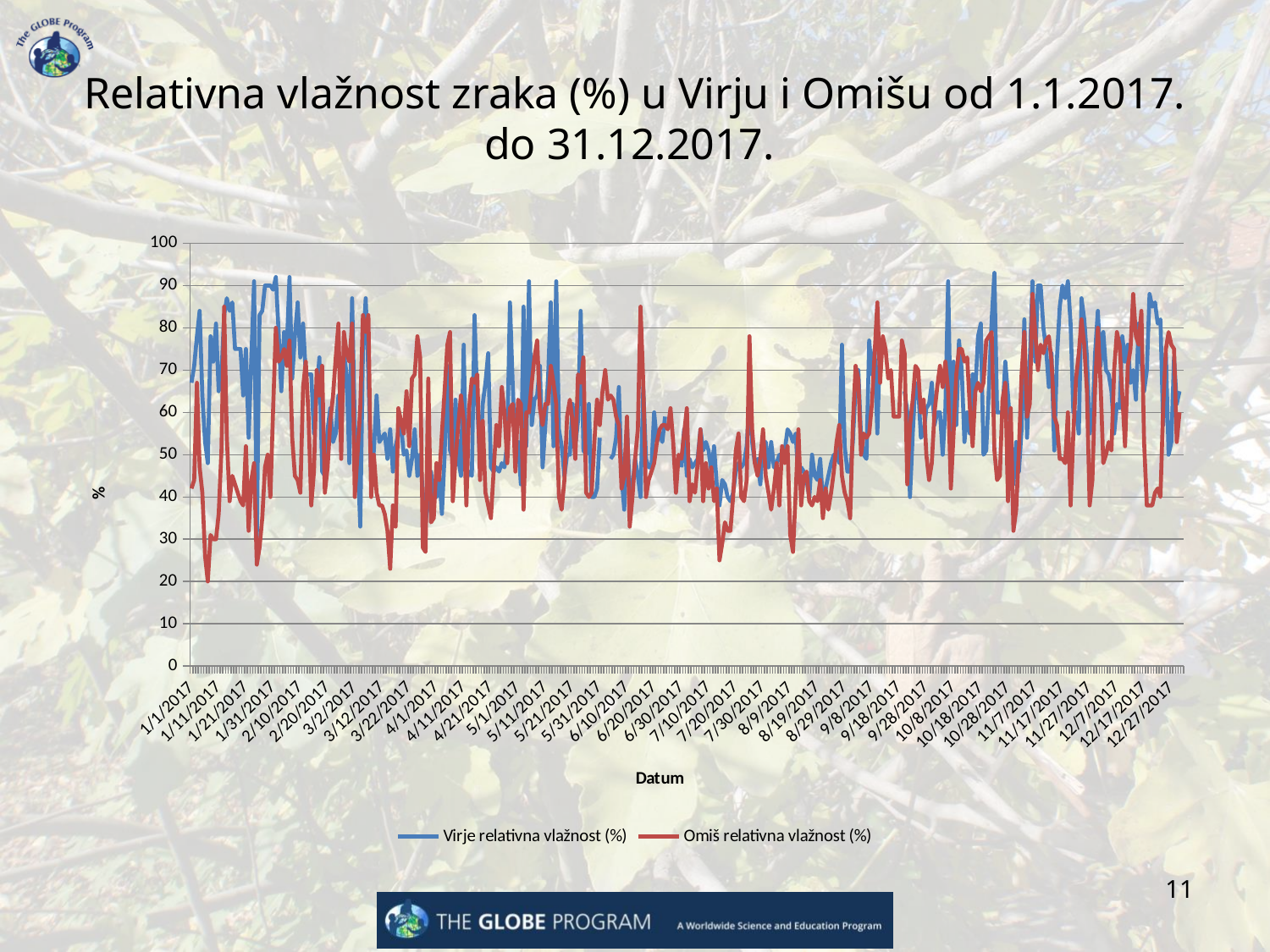
How many series does the legend list? 2 Which series drops to the lower minimum value over the year, Virje or Omiš? Omiš relativna vlažnost (%) What are the two series named in the legend? Virje relativna vlažnost (%) and Omiš relativna vlažnost (%) Is the highest value reached by the Virje relativna vlažnost (%) series greater or less than 80? greater What is the title of the chart's x axis? Datum What is the label on the chart's y axis? % What is the first date label shown on the x axis? 1/1/2017 What is the highest value shown on the y axis? 100 Is the lowest value reached by the Omiš relativna vlažnost (%) series greater or less than 30? less Which colour represents the Omiš relativna vlažnost (%) series? red What kind of chart is shown on the slide? line chart What is the last date label shown on the x axis? 12/27/2017